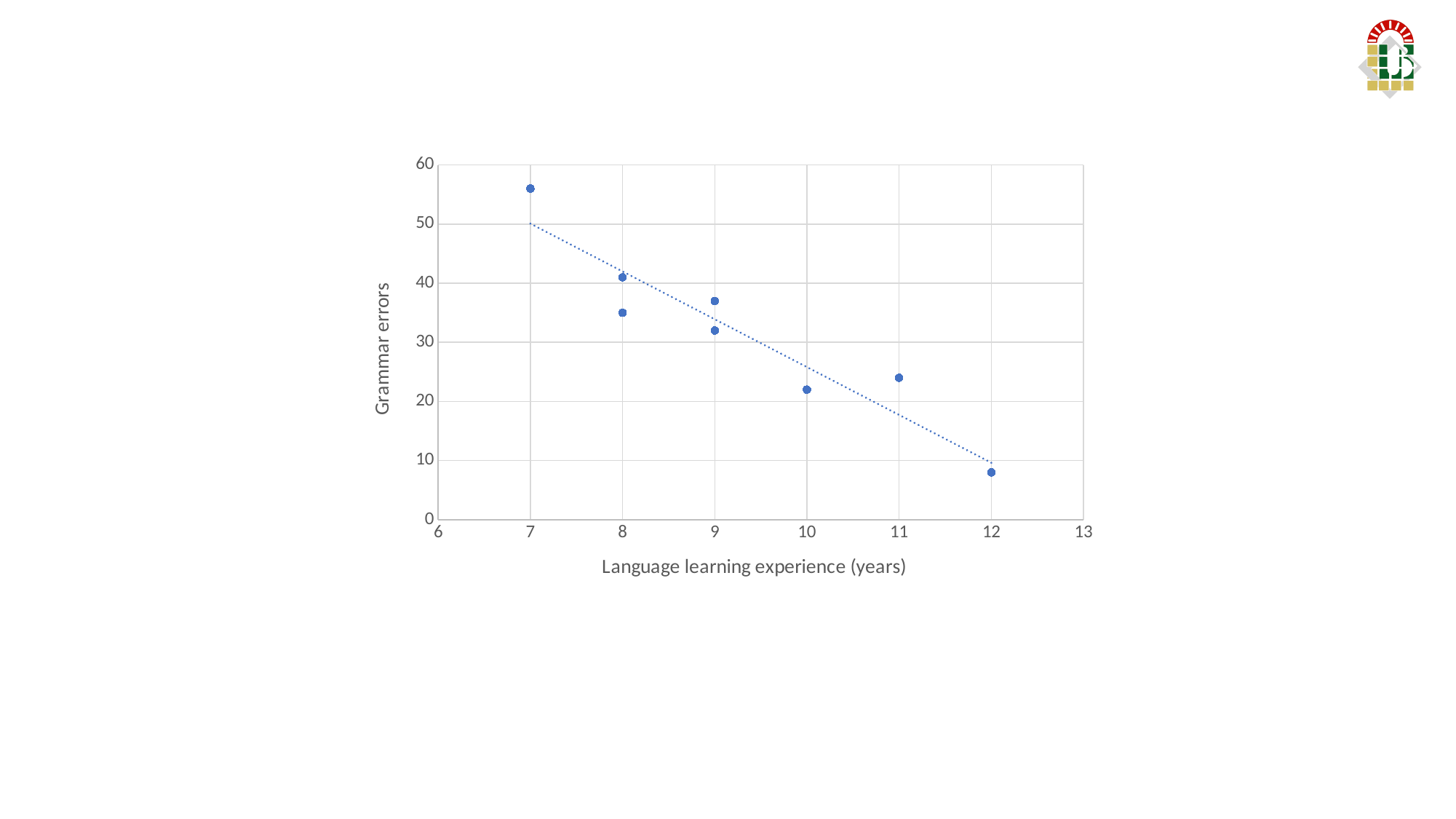
At which number of years of language learning experience is the highest number of grammar errors plotted? 7 What is the label of the vertical axis? Grammar errors At which number of years of language learning experience is the lowest number of grammar errors plotted? 12 Which has more grammar errors: the point at 7 years of experience or the point at 12 years of experience? 7 years Is the value for grammar errors at 7 years of experience greater or less than 50? greater Is the value for grammar errors at 12 years of experience greater or less than 10? less Do grammar errors rise or fall as language learning experience increases along the x axis? fall What is the label of the horizontal axis? Language learning experience (years) Is the value for grammar errors at 10 years of experience greater or less than 30? less How many data points are plotted on the chart? 8 What kind of chart is shown on the slide? scatter plot